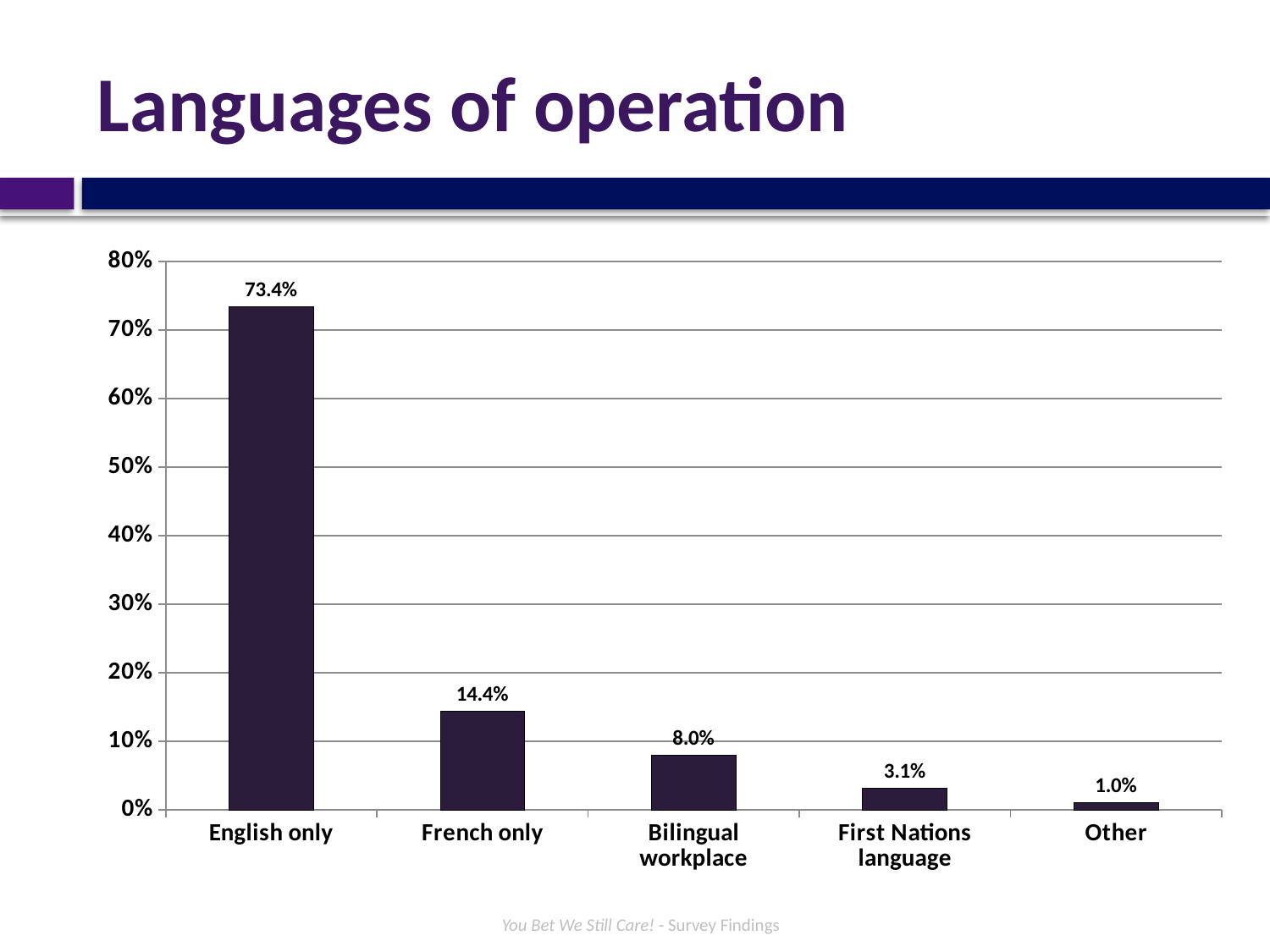
Is the value for English only greater or less than 70%? greater Which category has the highest value? English only Which category has the lowest value? Other What is the value for First Nations language? 3.1% What kind of chart is shown on the slide? bar chart What is the value for English only? 73.4% What is the difference between the values for English only and French only? 59.0% What is the value for French only? 14.4% What is the value for Bilingual workplace? 8.0% What is the difference between the values for Bilingual workplace and First Nations language? 4.9% Which is larger, the value for French only or the value for Bilingual workplace? French only How many categories are shown on the x axis? 5